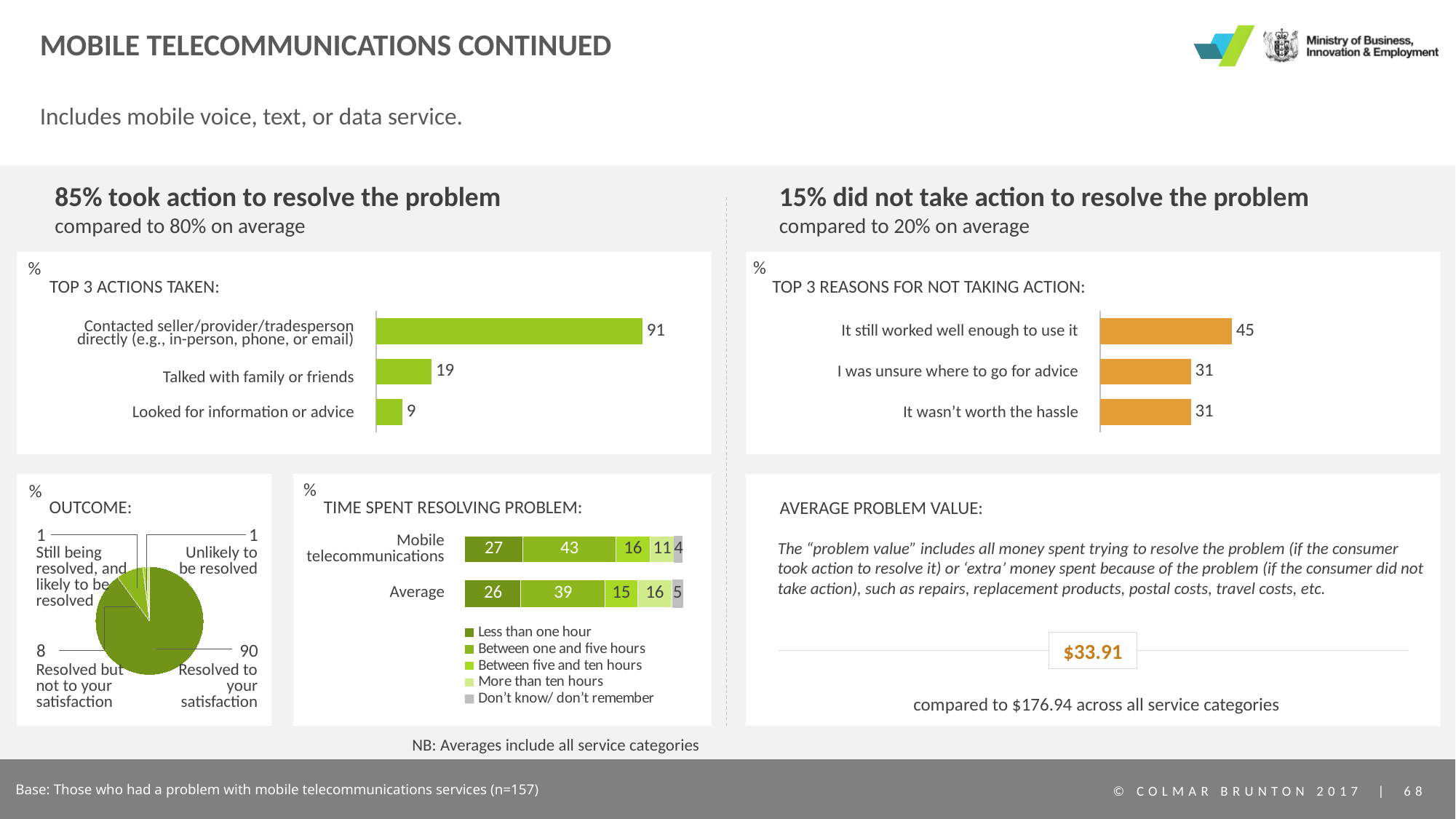
In the 'Time spent resolving problem' chart, what is the 'Between one and five hours' value for Mobile telecommunications? 43 In the 'Top 3 actions taken' chart, what is the difference between 'Contacted seller/provider/tradesperson directly' and 'Looked for information or advice'? 82 In the 'Top 3 reasons for not taking action' chart, how many reasons are shown? 3 In the 'Time spent resolving problem' chart, which is larger for 'Less than one hour': Mobile telecommunications or Average? Mobile telecommunications What kind of chart is the 'Top 3 reasons for not taking action' chart? Bar chart In the 'Time spent resolving problem' chart, what is the 'Don't know/ don't remember' value for Average? 5 In the 'Outcome' pie chart, what is the value for 'Resolved but not to your satisfaction'? 8 How many series does the legend of the 'Time spent resolving problem' chart list? 5 In the 'Top 3 actions taken' chart, which action has the highest value? Contacted seller/provider/tradesperson directly (e.g., in-person, phone, or email) In the 'Outcome' pie chart, what share is 'Resolved to your satisfaction'? 90 In the 'Top 3 reasons for not taking action' chart, what is the value for 'It still worked well enough to use it'? 45 In the 'Top 3 actions taken' chart, what is the value for 'Talked with family or friends'? 19